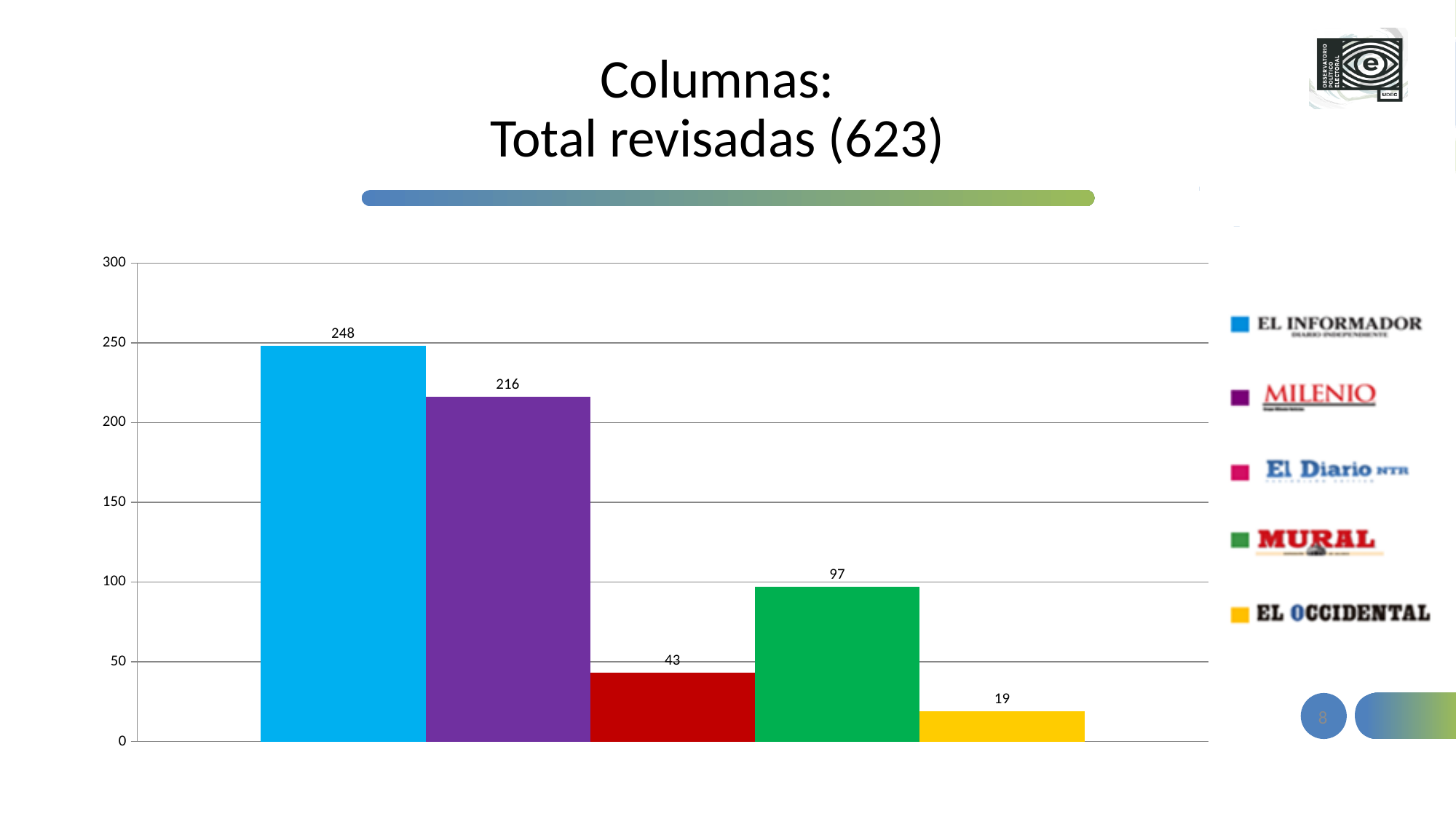
What is the difference between the values for El Informador and Milenio? 32 What kind of chart is shown on the slide? Bar chart What is the value for El Occidental? 19 What is the value for El Informador? 248 What is the value for Mural? 97 What is the value for Milenio? 216 How many bars are shown in the chart? 5 Which newspaper has the highest value? El Informador Which is larger, the value for Mural or the value for El Diario NTR? Mural Which newspaper has the lowest value? El Occidental What is the value for El Diario NTR? 43 What colour is the bar for Mural? Green